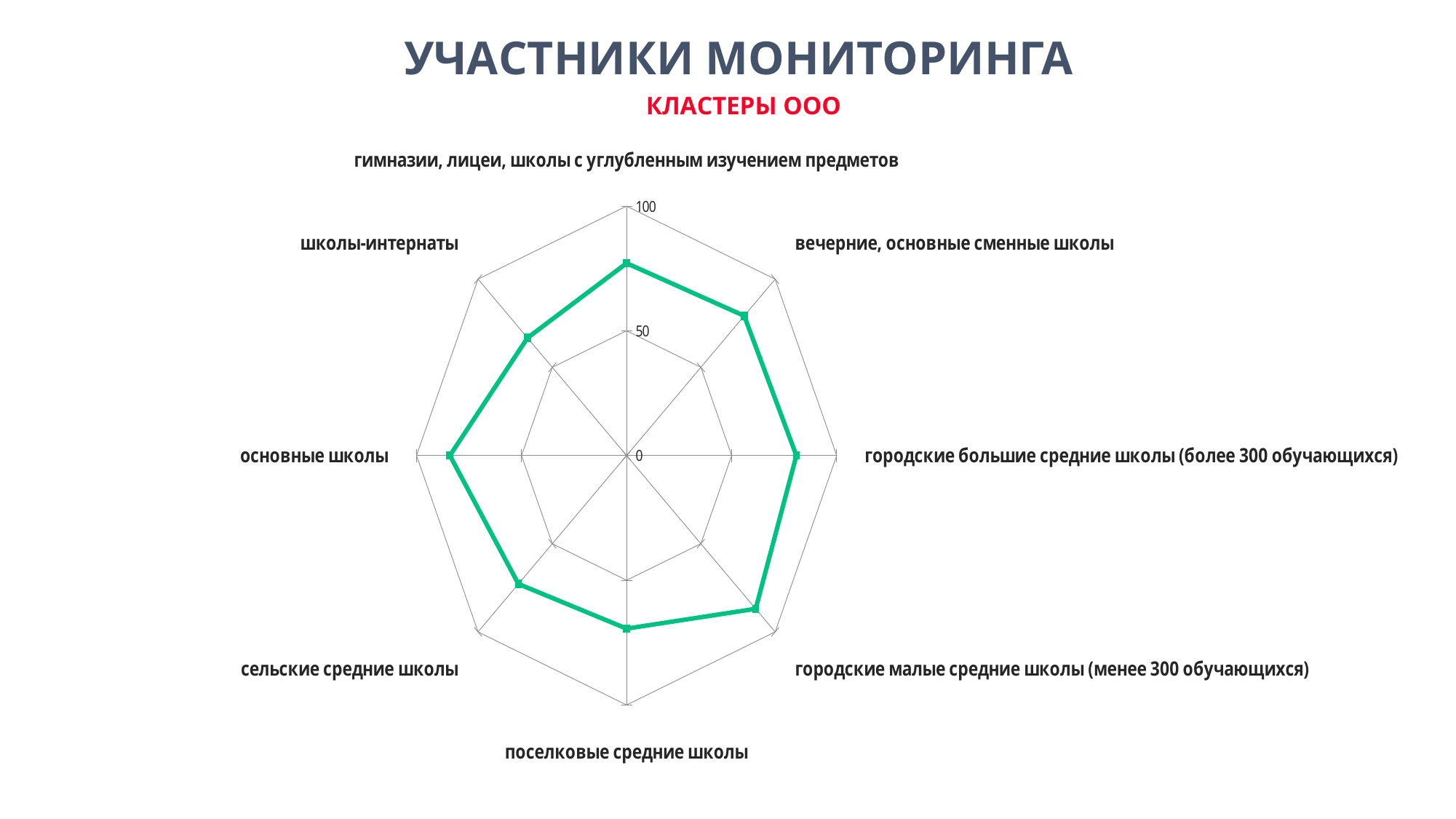
Is the value for поселковые средние школы greater or less than 50? greater What kind of chart is shown on the slide? radar chart How many categories (school clusters) are plotted on the radar chart? 8 Is the value for школы-интернаты greater or less than 100? less How many data series are plotted on the radar chart? 1 Is the value for основные школы greater or less than 50? greater What is the red subtitle above the chart? КЛАСТЕРЫ ООО What is the maximum value shown on the radar chart's axis? 100 Which is larger: the value for основные школы or the value for школы-интернаты? основные школы Which is larger: the value for городские малые средние школы (менее 300 обучающихся) or the value for поселковые средние школы? городские малые средние школы (менее 300 обучающихся)